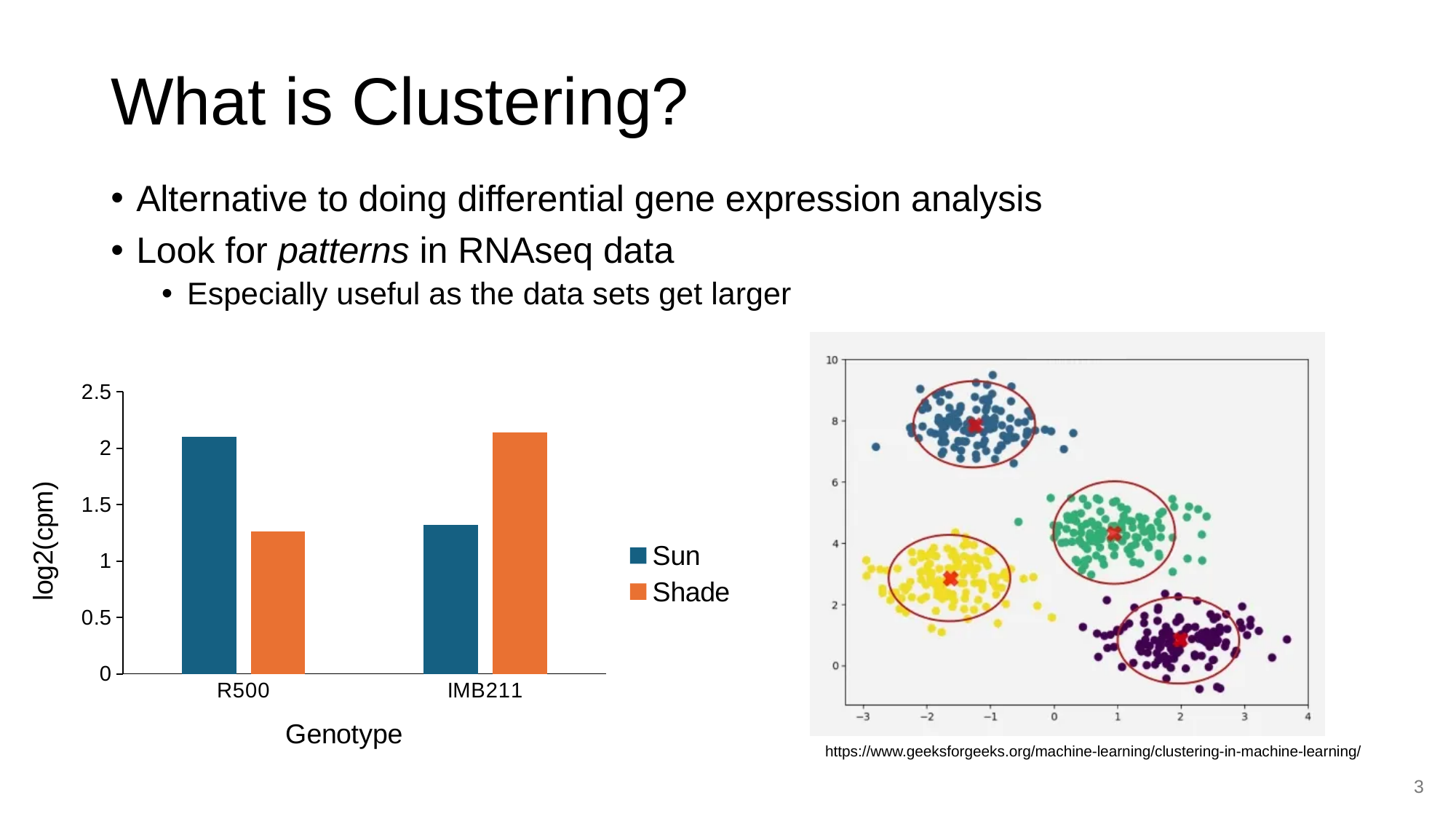
On the bar chart on the left, for IMB211, which is larger: Sun or Shade? Shade On the bar chart on the left, is the Shade value for IMB211 greater or less than 2? greater On the bar chart on the left, how many genotype categories are shown on the x axis? 2 On the bar chart on the left, is the Sun value for R500 greater or less than 2? greater On the bar chart on the left, is the Shade value for R500 greater or less than 1.5? less On the bar chart on the left, for R500, which is larger: Sun or Shade? Sun On the chart on the right, how many circled clusters are shown? 4 On the bar chart on the left, what kind of chart is it? bar chart On the bar chart on the left, which series is shown in orange? Shade On the bar chart on the left, how many series does the legend list? 2 On the bar chart on the left, what is the y-axis label? log2(cpm)